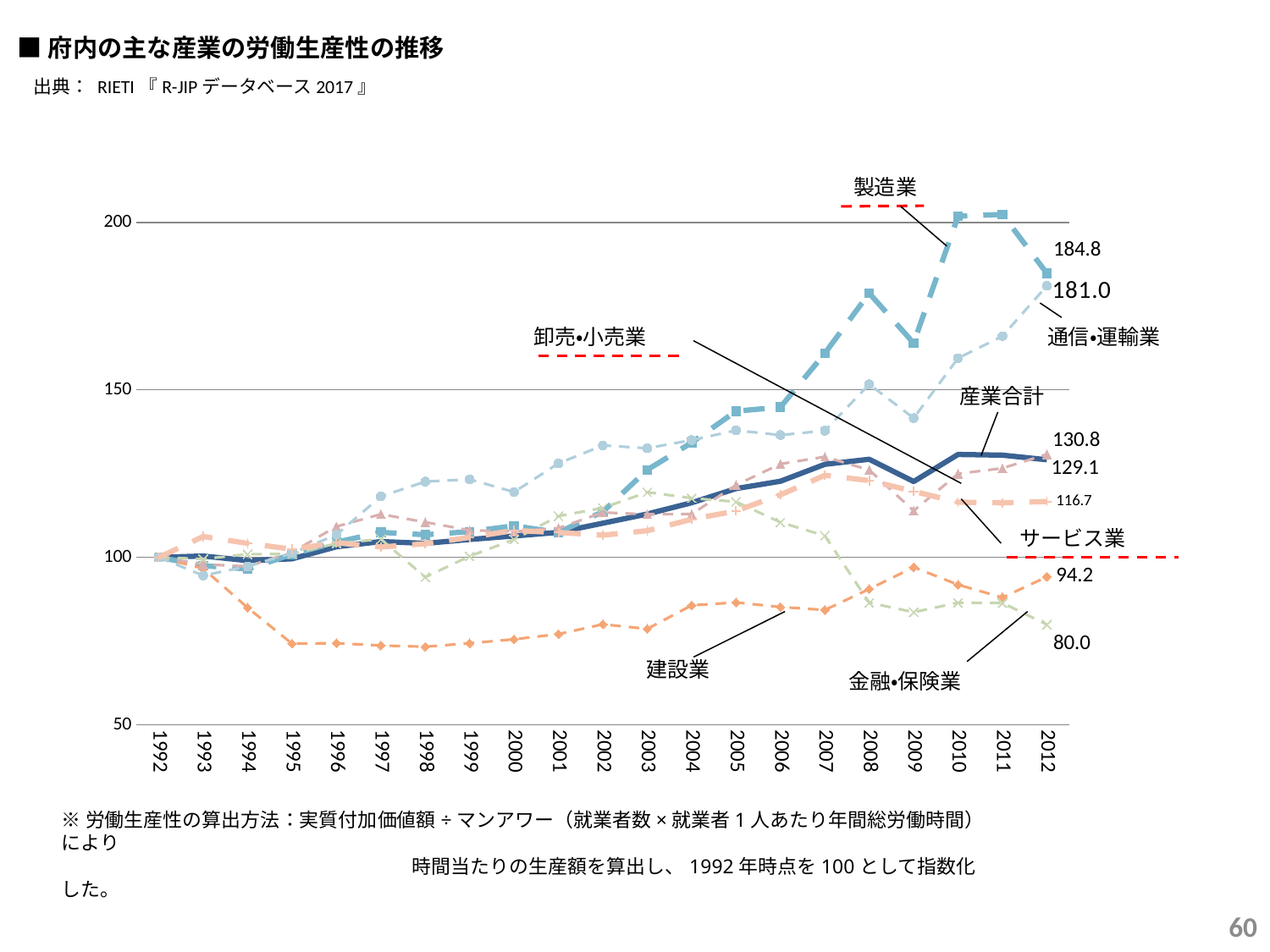
What kind of chart is shown on the slide? line chart What is the difference between the 2012 values of 製造業 and 通信・運輸業? 3.8 What is the source cited for the chart data? RIETI 『R-JIP データベース 2017』 Which industry has the highest value in 2012? 製造業 What is the 2012 value for 製造業? 184.8 How many industry series are plotted in the chart? 7 Is the value for 製造業 in 2008 greater or less than 150? greater What is the 2012 value for 産業合計? 129.1 What is the 2012 value for 通信・運輸業? 181.0 What is the 2012 value for 金融・保険業? 80.0 What is the 2012 value for 建設業? 94.2 Which industry has the lowest value in 2012? 金融・保険業